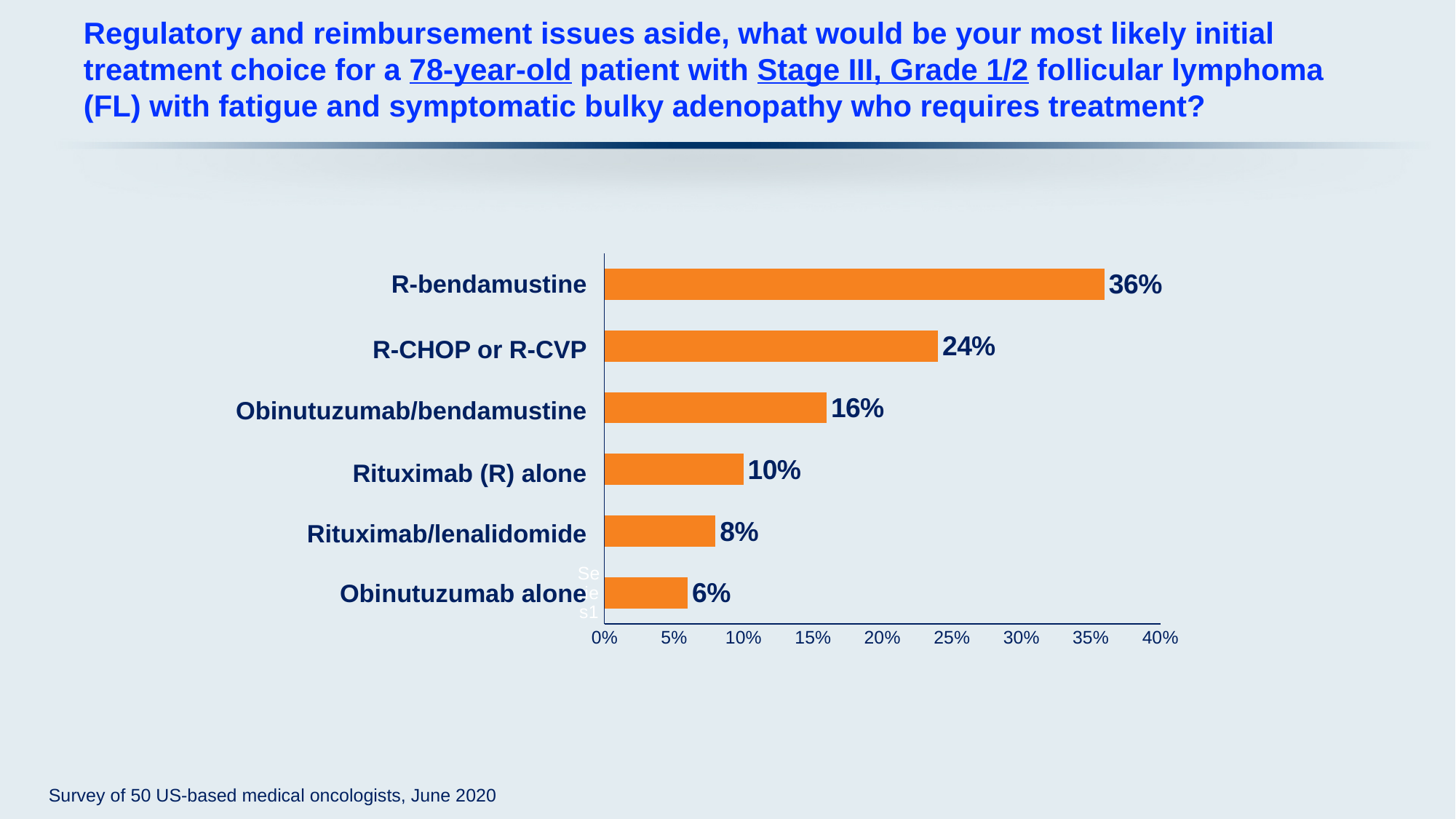
What percentage of respondents chose R-bendamustine? 36% What is the difference between Rituximab (R) alone and Obinutuzumab alone? 4% What is the maximum value shown on the horizontal axis? 40% What is the value for Rituximab/lenalidomide? 8% Which is larger, the value for Obinutuzumab/bendamustine or the value for Rituximab (R) alone? Obinutuzumab/bendamustine What percentage chose Obinutuzumab/bendamustine? 16% What kind of chart is shown on the slide? Bar chart What is the difference between the values for R-bendamustine and R-CHOP or R-CVP? 12% What is the value for R-CHOP or R-CVP? 24% How many treatment choices are shown in the chart? 6 Which treatment choice has the highest percentage? R-bendamustine Which treatment choice has the lowest percentage? Obinutuzumab alone